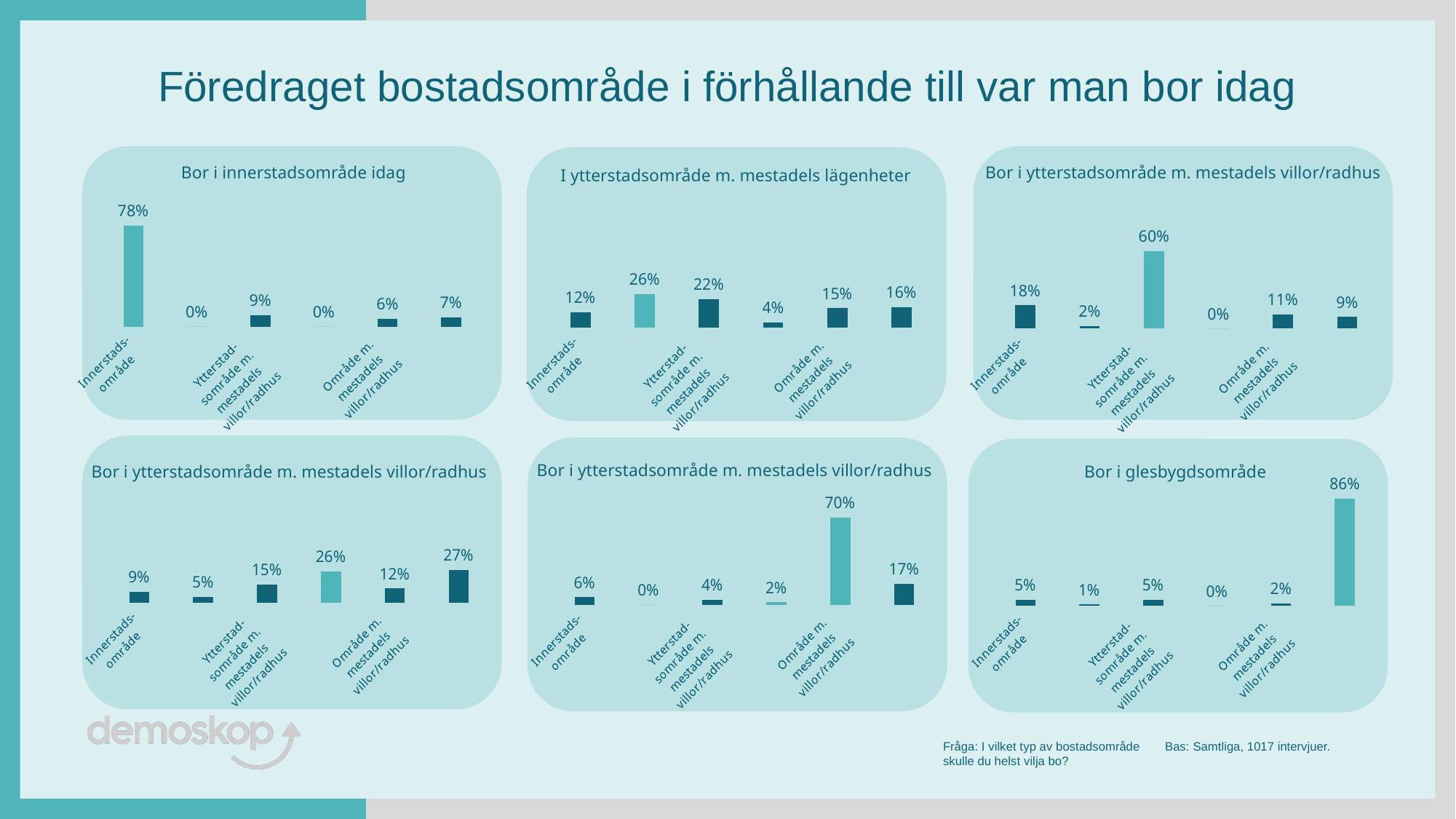
In the bottom-right chart (Bor i glesbygdsområde), what is the highest value shown? 86% In the top-right chart, what is the highest value shown? 60% In the top-right chart, what is the difference between the value for Innerstadsområde and the value for Område m. mestadels villor/radhus? 7 percentage points In the bottom-left chart, what is the value for Område m. mestadels villor/radhus? 12% In the top-left chart (Bor i innerstadsområde idag), what is the highest value shown? 78% What type of chart is used in the bottom-right chart (Bor i glesbygdsområde)? Bar chart In the top-left chart (Bor i innerstadsområde idag), what is the value for Innerstadsområde? 78% In the top-middle chart (I ytterstadsområde m. mestadels lägenheter), which is larger: the value for Innerstadsområde or the value for Ytterstadsområde m. mestadels villor/radhus? Ytterstadsområde m. mestadels villor/radhus In the top-middle chart (I ytterstadsområde m. mestadels lägenheter), what is the value for Ytterstadsområde m. mestadels villor/radhus? 22% How many bars are plotted in the top-left chart (Bor i innerstadsområde idag)? 6 In the bottom-right chart (Bor i glesbygdsområde), what is the value for Innerstadsområde? 5%